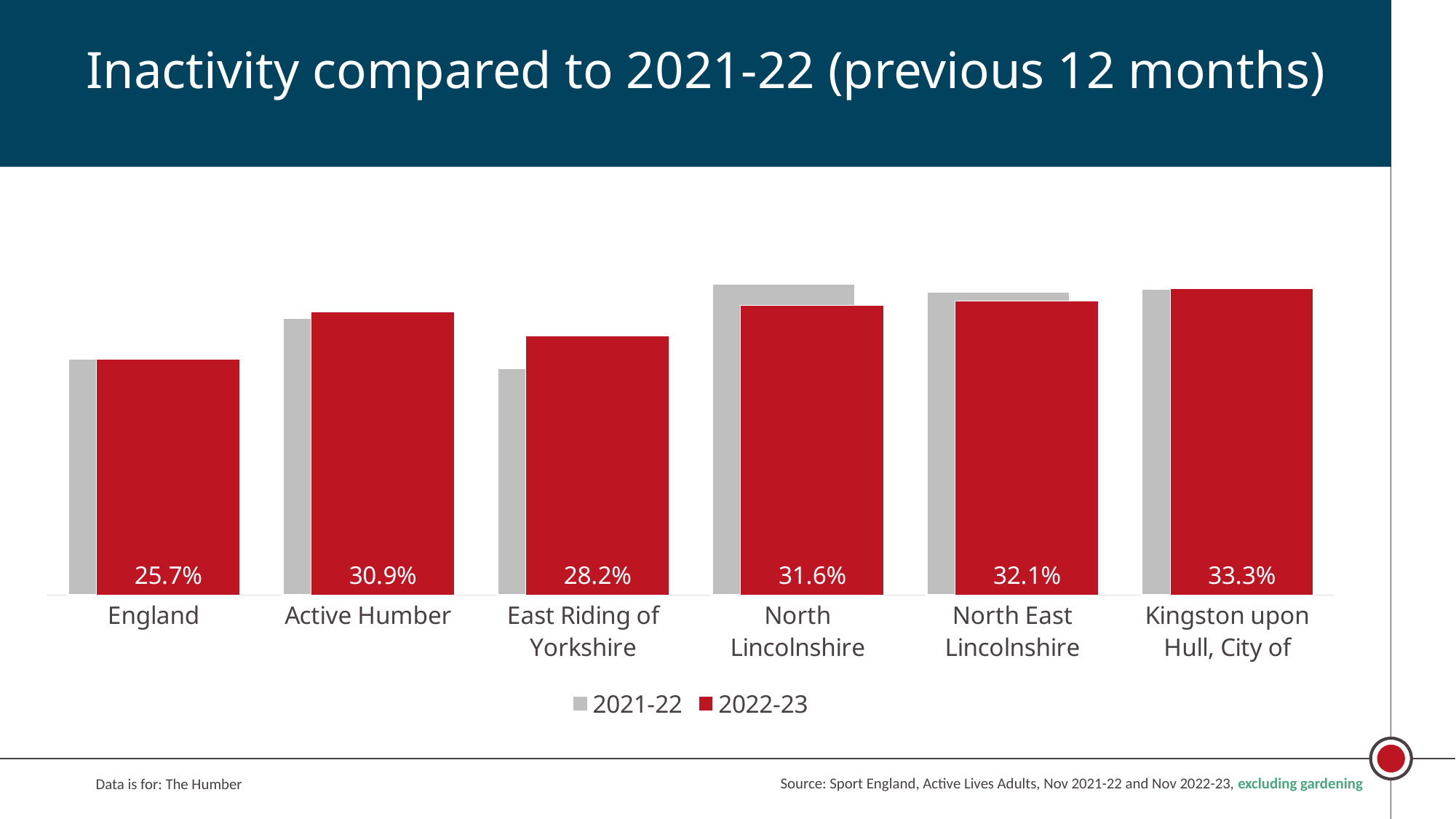
What is the 2022-23 inactivity value for England? 25.7% Which category has the highest 2022-23 inactivity value? Kingston upon Hull, City of What is the difference between the 2022-23 values for North East Lincolnshire and North Lincolnshire? 0.5% For East Riding of Yorkshire, which is larger: the 2021-22 bar or the 2022-23 bar? 2022-23 What is the difference between the 2022-23 values for Active Humber and England? 5.2% How many series does the legend list? 2 What is the 2022-23 inactivity value for Kingston upon Hull, City of? 33.3% For North Lincolnshire, which is larger: the 2021-22 bar or the 2022-23 bar? 2021-22 Which category has the lowest 2022-23 inactivity value? England How many categories are shown on the x axis? 6 What is the 2022-23 inactivity value for East Riding of Yorkshire? 28.2% What is the 2022-23 inactivity value for Active Humber? 30.9%